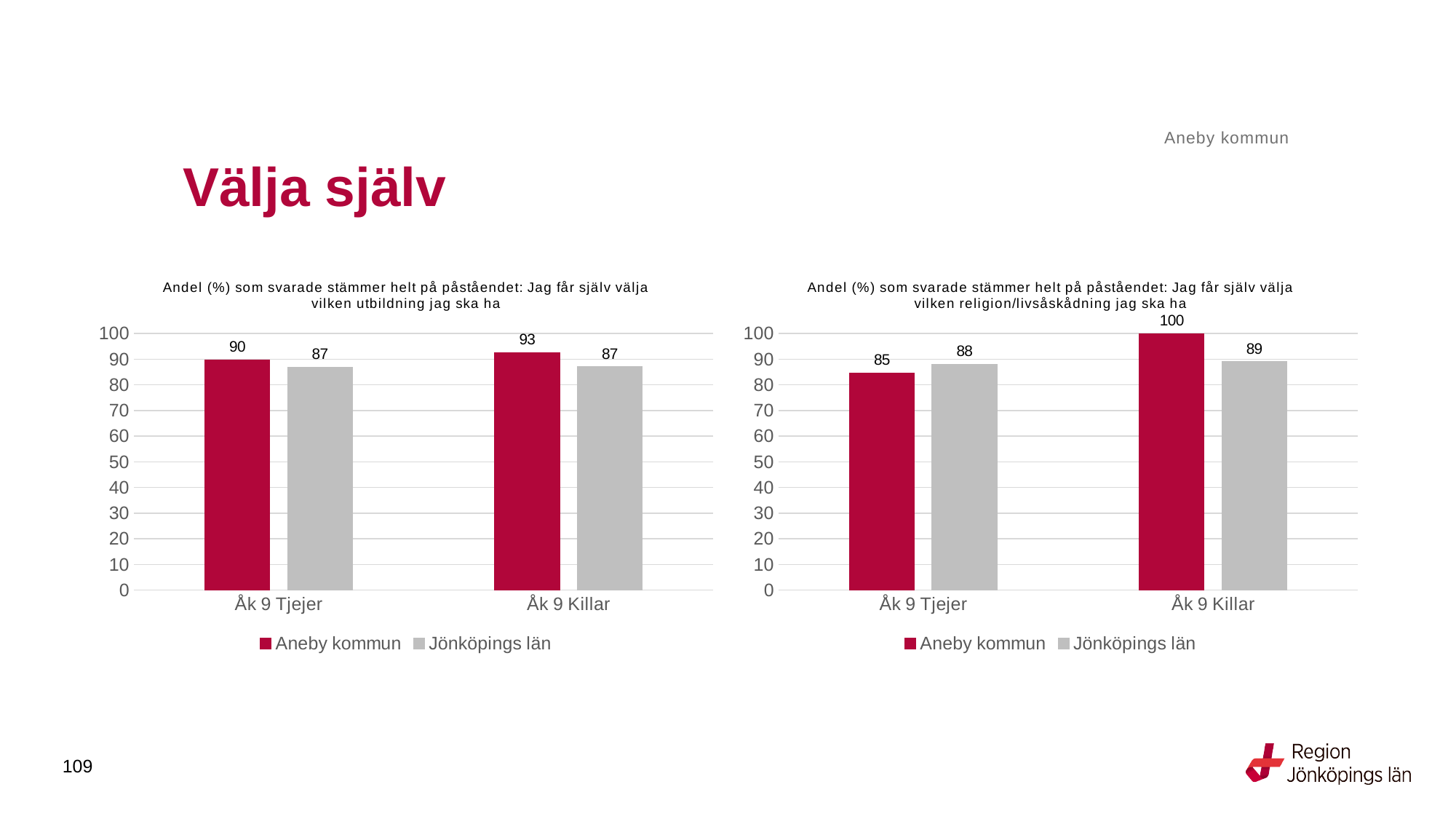
In the right chart (about choosing religion/livsåskådning), which category has the highest value for Aneby kommun? Åk 9 Killar How many series does the legend of the left chart list? 2 In the right chart (about choosing religion/livsåskådning), what is the difference between Aneby kommun and Jönköpings län for Åk 9 Killar? 11 How many categories are shown on the x axis of the right chart? 2 In the left chart (about choosing education), what is the value for Aneby kommun for Åk 9 Tjejer? 90 In the right chart (about choosing religion/livsåskådning), what is the value for Jönköpings län for Åk 9 Tjejer? 88 In the left chart (about choosing education), which category has the lowest value for Aneby kommun? Åk 9 Tjejer What kind of chart is the left chart? Bar chart In the right chart (about choosing religion/livsåskådning), which is larger for Åk 9 Tjejer: Aneby kommun or Jönköpings län? Jönköpings län In the right chart (about choosing religion/livsåskådning), what is the value for Aneby kommun for Åk 9 Killar? 100 In the left chart (about choosing education), what is the value for Jönköpings län for Åk 9 Killar? 87 In the left chart (about choosing education), what is the difference between Aneby kommun and Jönköpings län for Åk 9 Killar? 6